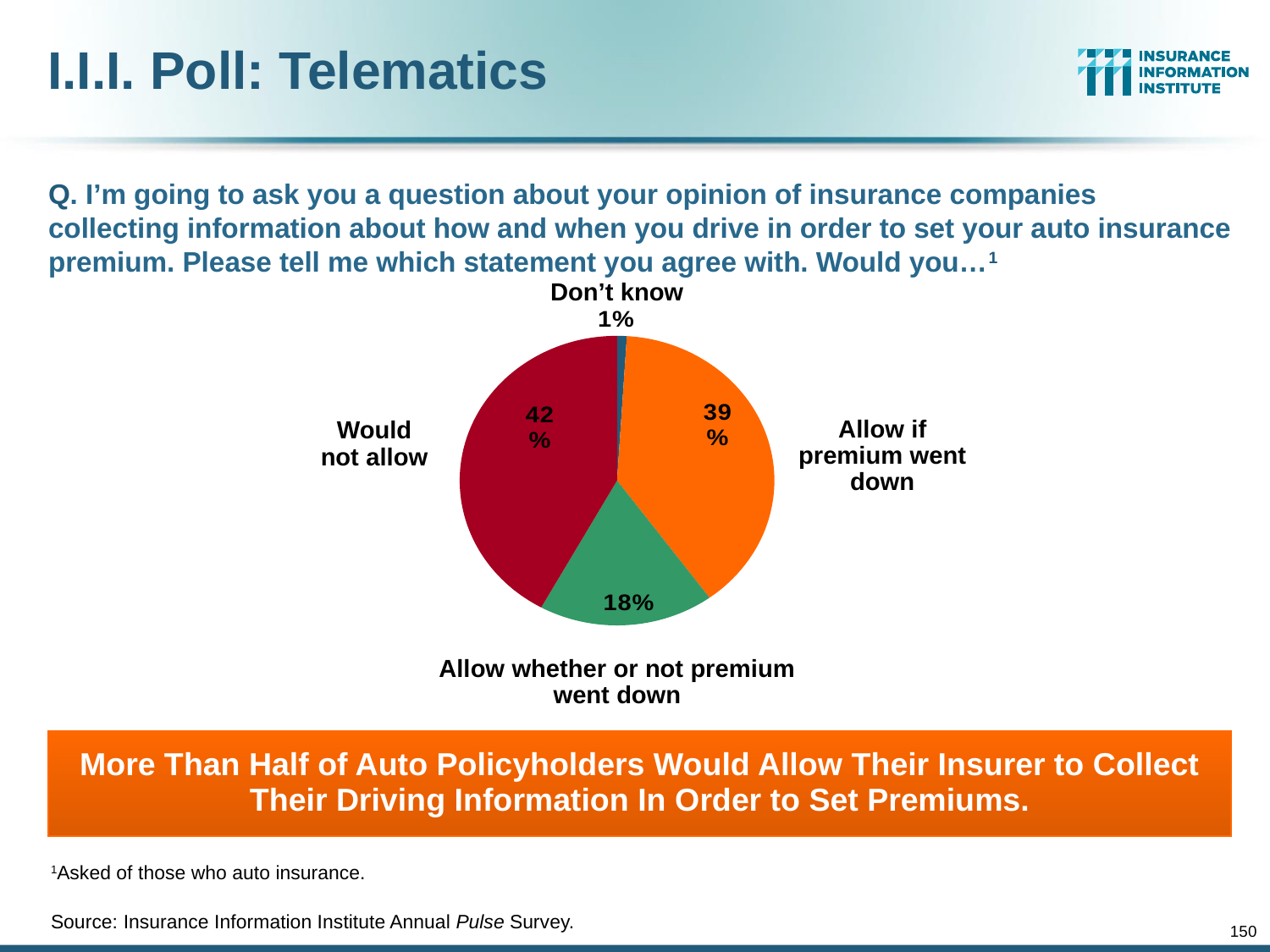
How many percentage points larger is "Would not allow" than "Allow if premium went down"? 3 percentage points What percentage of respondents would allow data collection whether or not their premium went down? 18% What share of respondents answered "Don't know"? 1% Which is larger: the share for "Allow if premium went down" or the share for "Allow whether or not premium went down"? Allow if premium went down What share of respondents said they would not allow insurers to collect driving information? 42% How many response categories are shown in the pie chart? 4 What percentage of respondents would allow data collection if their premium went down? 39% Which response has the smallest slice of the pie? Don't know What is the difference in percentage points between "Allow if premium went down" and "Allow whether or not premium went down"? 21 percentage points What is the combined share of the two "Allow" responses? 57% Which response has the largest slice of the pie? Would not allow What type of chart is shown on the slide? Pie chart